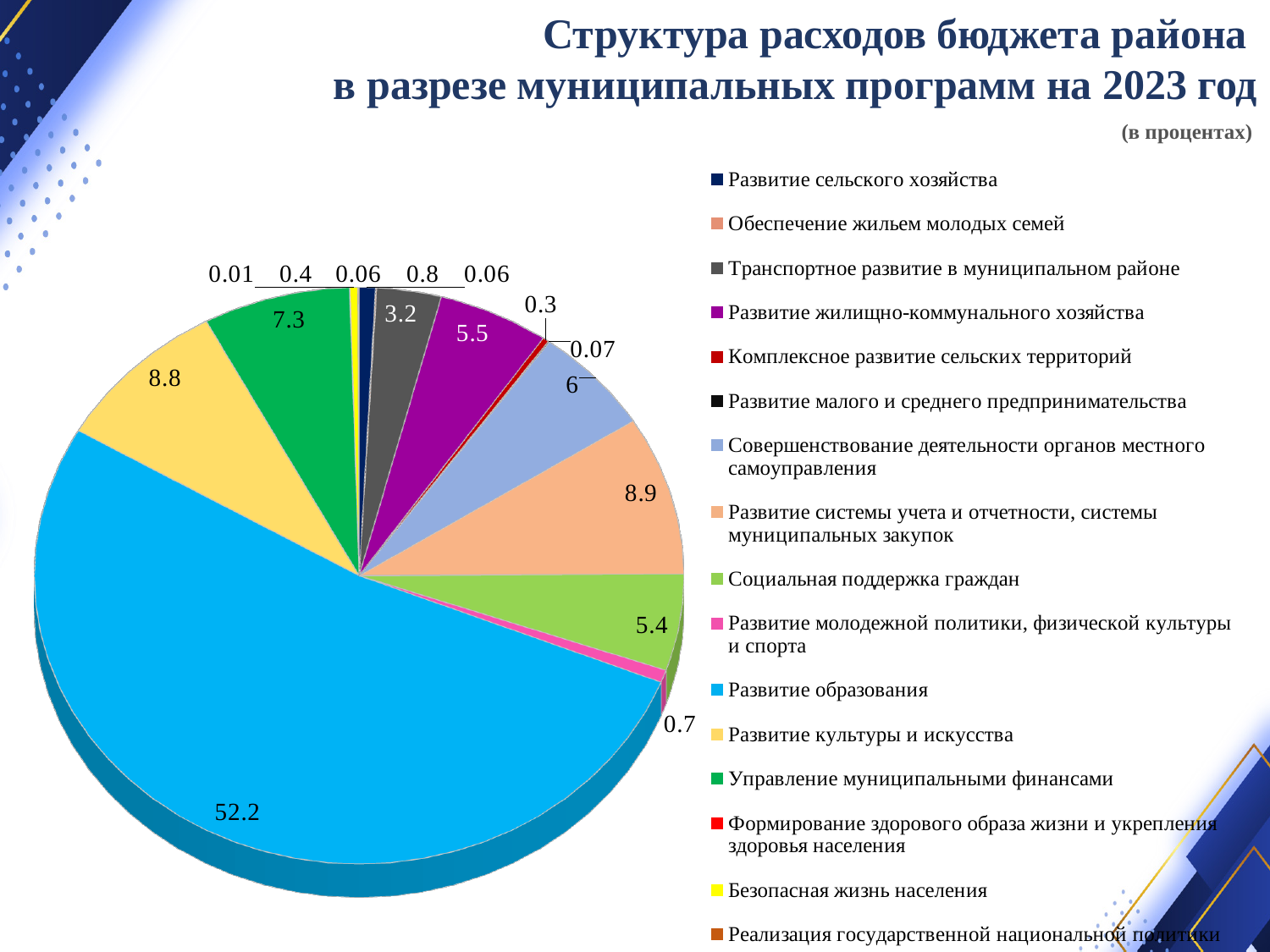
What is the value for Управление муниципальными финансами? 7.3 Which is larger: the value for Управление муниципальными финансами or the value for Социальная поддержка граждан? Управление муниципальными финансами What is the value for Развитие образования? 52.2 How many categories does the legend list? 16 What is the value for Социальная поддержка граждан? 5.4 What is the value for Развитие жилищно-коммунального хозяйства? 5.5 What is the value for Транспортное развитие в муниципальном районе? 3.2 Which category has the largest share of the pie? Развитие образования What is the value for Развитие культуры и искусства? 8.8 What is the value for Развитие системы учета и отчетности, системы муниципальных закупок? 8.9 What is the difference between the values for Развитие образования and Развитие системы учета и отчетности, системы муниципальных закупок? 43.3 What kind of chart is shown on the slide? pie chart